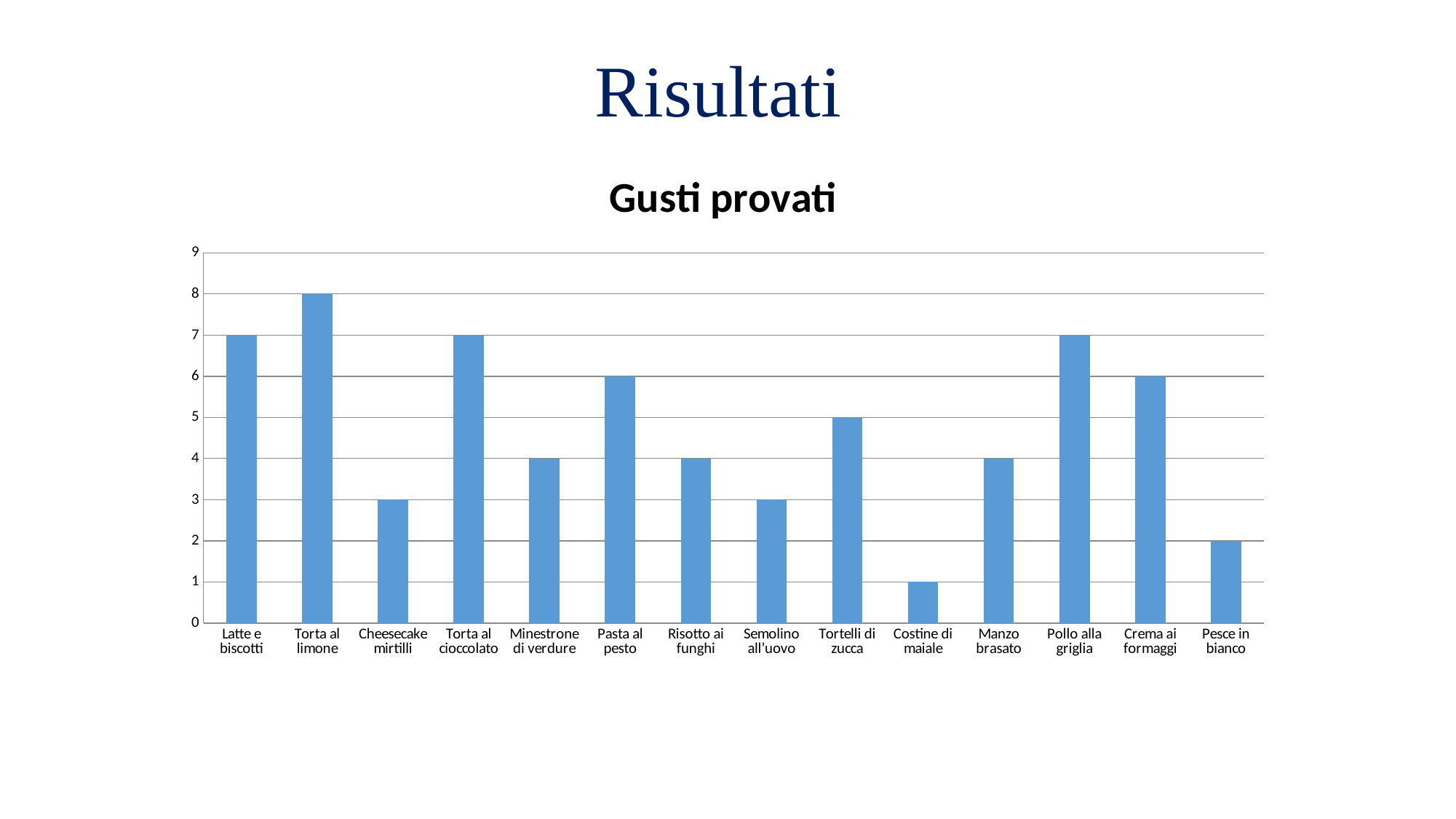
How many categories are shown on the x axis? 14 What is the value for Costine di maiale? 1 Is the value for Pollo alla griglia greater or less than 5? greater What is the value for Torta al limone? 8 What kind of chart is shown on the slide? Bar chart Which category has the highest value? Torta al limone What is the value for Pesce in bianco? 2 What is the value for Tortelli di zucca? 5 What is the difference between the values for Torta al limone and Cheesecake mirtilli? 5 Which category has the lowest value? Costine di maiale Which is larger, the value for Pasta al pesto or the value for Risotto ai funghi? Pasta al pesto What is the title of the chart? Gusti provati